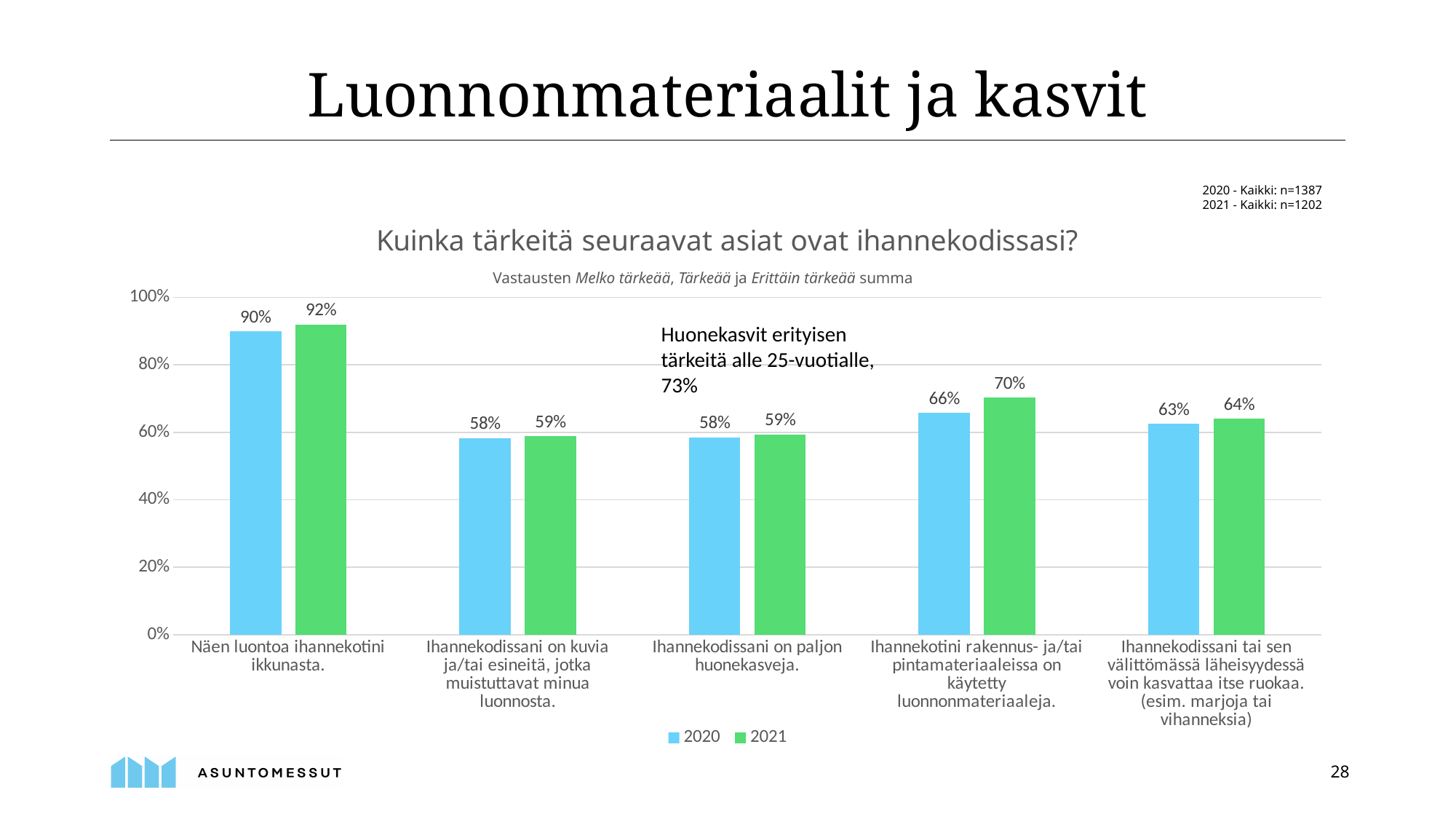
What is the difference between the 2021 and 2020 values for "Ihannekotini rakennus- ja/tai pintamateriaaleissa on käytetty luonnonmateriaaleja."? 4% What kind of chart is shown on the slide? Bar chart What is the 2021 value for "Ihannekodissani on paljon huonekasveja."? 59% Which colour represents the 2021 series? Green Which category has the lowest 2021 value? Ihannekodissani on kuvia ja/tai esineitä, jotka muistuttavat minua luonnosta. and Ihannekodissani on paljon huonekasveja. (both 59%) Which is larger for "Ihannekodissani tai sen välittömässä läheisyydessä voin kasvattaa itse ruokaa.": the 2020 value or the 2021 value? 2021 How many series does the legend list? 2 What is the 2020 value for "Ihannekotini rakennus- ja/tai pintamateriaaleissa on käytetty luonnonmateriaaleja."? 66% Which category has the highest 2020 value? Näen luontoa ihannekotini ikkunasta. What is the 2021 value for "Näen luontoa ihannekotini ikkunasta."? 92% How many categories are shown on the x axis? 5 What is the chart's title? Kuinka tärkeitä seuraavat asiat ovat ihannekodissasi?